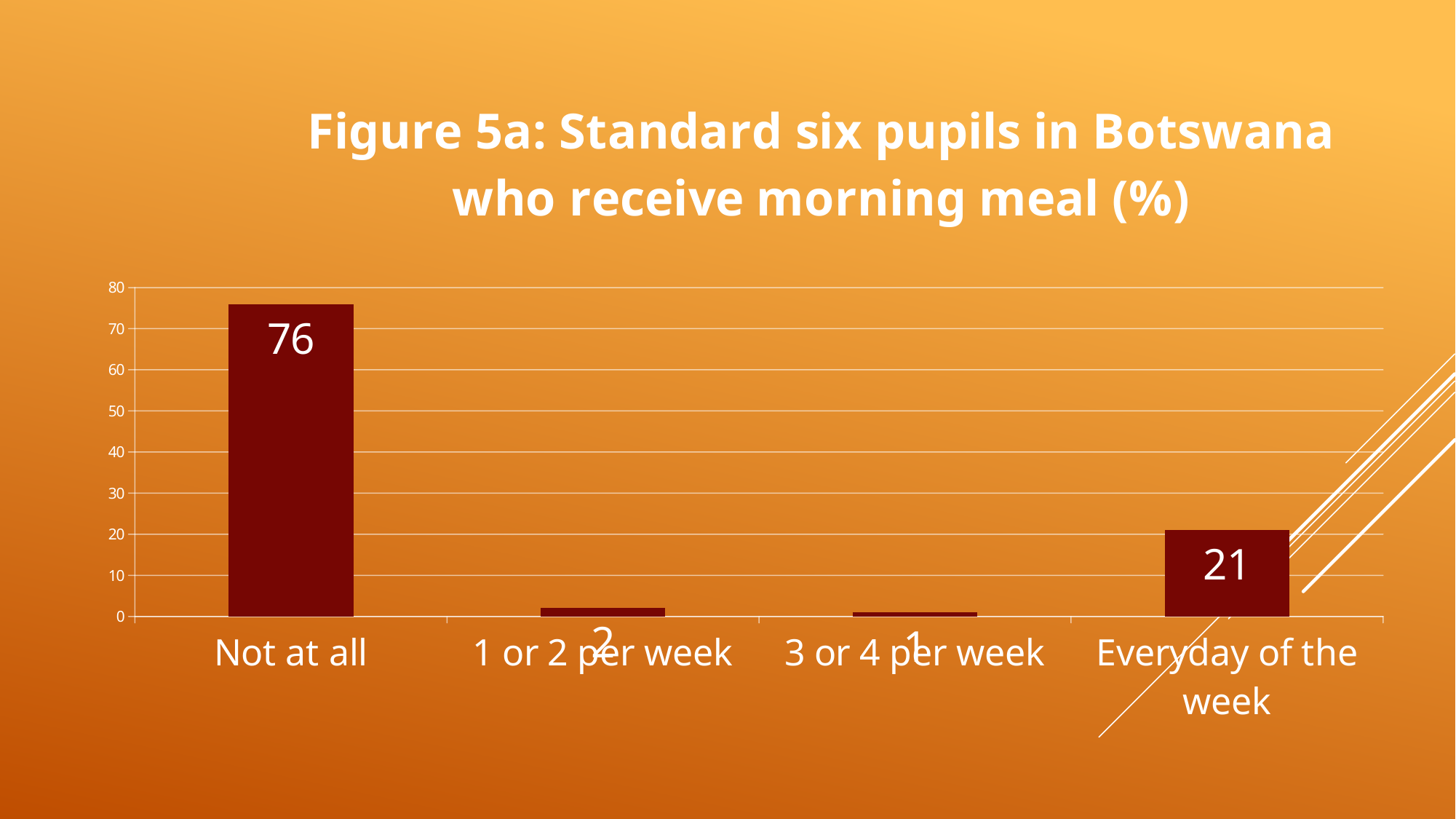
Which category has the highest value? Not at all What is the difference between the values for "Not at all" and "Everyday of the week"? 55 What is the value for "Everyday of the week"? 21 Which category has the lowest value? 3 or 4 per week Is the value for "Not at all" greater or less than 70? greater Which is larger, the value for "Everyday of the week" or the value for "1 or 2 per week"? Everyday of the week What is the value for "3 or 4 per week"? 1 What kind of chart is shown on the slide? bar chart What is the title of the chart? Figure 5a: Standard six pupils in Botswana who receive morning meal (%) What is the value for "1 or 2 per week"? 2 What is the value for "Not at all"? 76 How many categories are shown on the x axis? 4